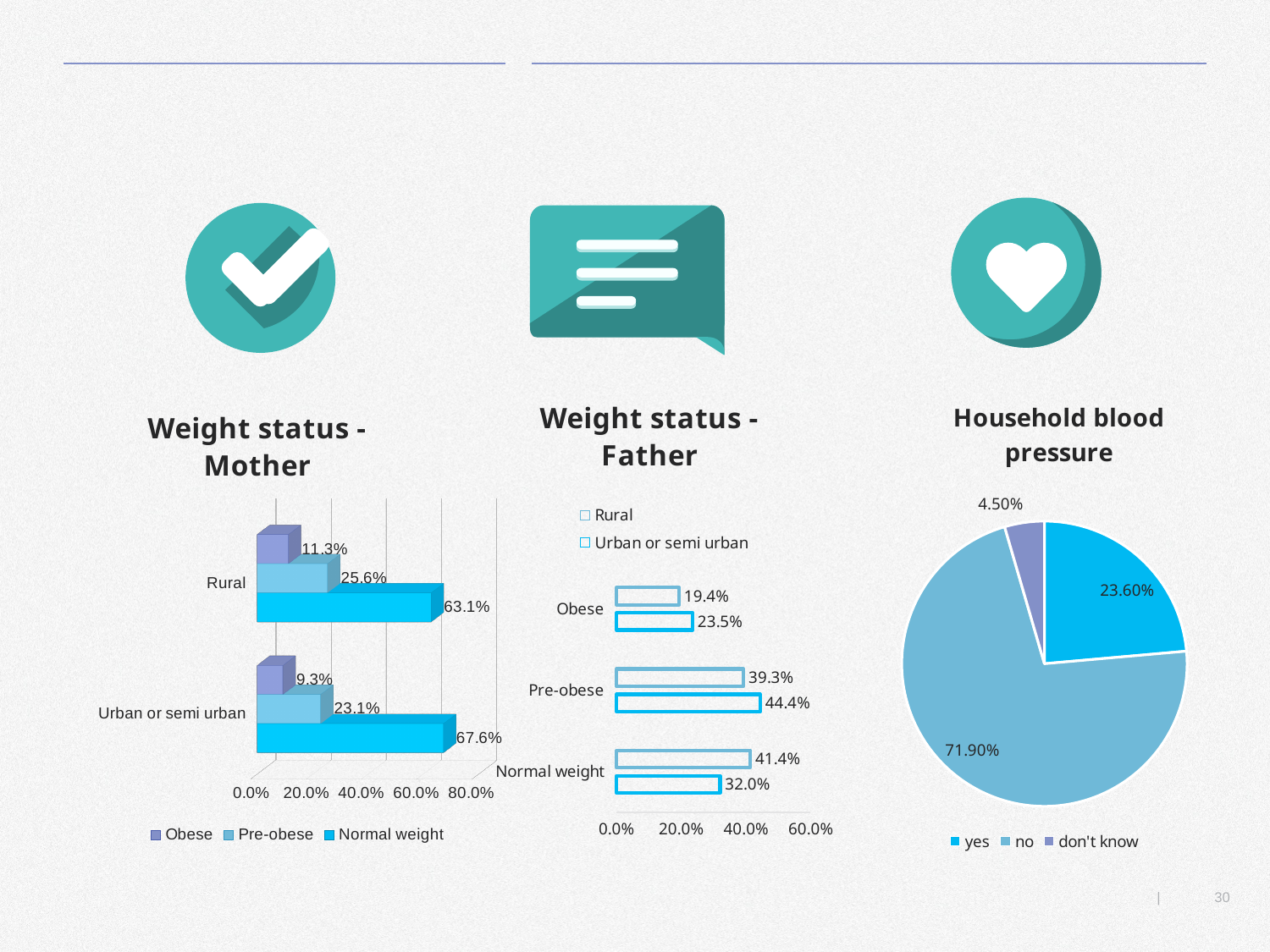
In the 'Weight status - Mother' chart, what is the Normal weight value for Rural? 63.1% In the 'Weight status - Father' chart, what is the Urban or semi urban value for Pre-obese? 44.4% In the 'Weight status - Mother' chart, what is the Obese value for Urban or semi urban? 9.3% In the 'Household blood pressure' chart, which slice is the smallest? don't know In the 'Weight status - Mother' chart, what is the difference between the Pre-obese values for Rural and Urban or semi urban? 2.5% In the 'Household blood pressure' chart, what is the share for 'no'? 71.90% In the 'Weight status - Father' chart, which category has the lowest Rural value? Obese What kind of chart is the 'Household blood pressure' chart? Pie chart In the 'Weight status - Mother' chart, how many series does the legend list? 3 In the 'Weight status - Father' chart, what is the difference between the Rural and Urban or semi urban values for Normal weight? 9.4% In the 'Weight status - Father' chart, what is the Rural value for Normal weight? 41.4% In the 'Weight status - Mother' chart, which category has the higher Normal weight value, Rural or Urban or semi urban? Urban or semi urban